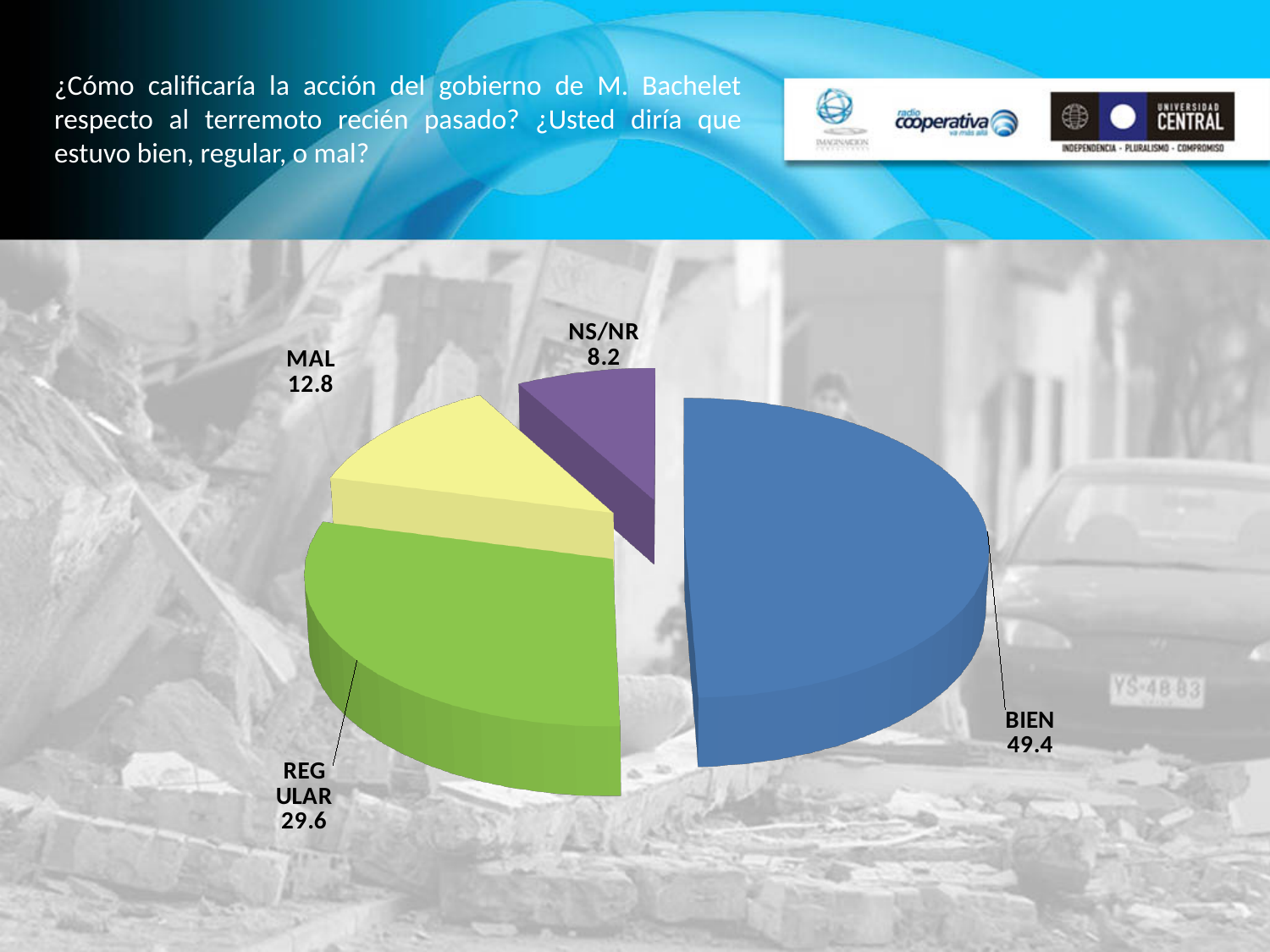
What is the value for MAL? 12.8 Which category has the smallest slice? NS/NR What is the difference between the values for MAL and NS/NR? 4.6 How many slices does the pie chart have? 4 What is the difference between the values for BIEN and REGULAR? 19.8 Which category has the largest slice? BIEN What kind of chart is shown on the slide? pie chart What is the value for REGULAR? 29.6 Which is larger, the value for REGULAR or the value for MAL? REGULAR What is the value for NS/NR? 8.2 What is the value for BIEN? 49.4 What colour is the BIEN slice? blue